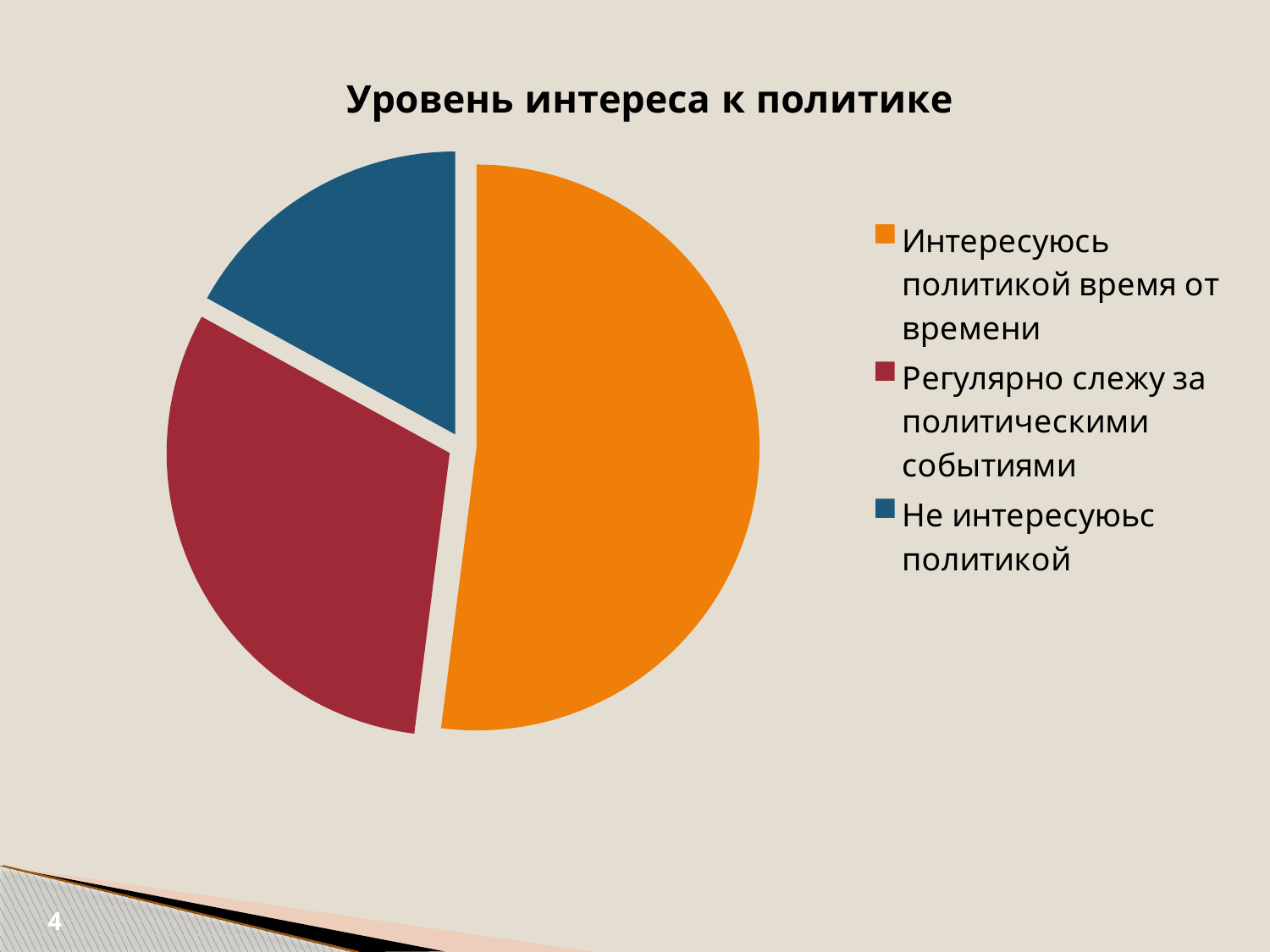
Which slice is larger: "Интересуюсь политикой время от времени" or "Регулярно слежу за политическими событиями"? Интересуюсь политикой время от времени What kind of chart is shown on the slide? Pie chart Which category has the smallest slice of the pie? Не интересуюьс политикой What colour is the slice for "Не интересуюьс политикой"? Blue What is the title of the chart? Уровень интереса к политике How many slices does the pie chart have? 3 How many entries does the legend list? 3 Which slice is larger: "Регулярно слежу за политическими событиями" or "Не интересуюьс политикой"? Регулярно слежу за политическими событиями Which category has the largest slice of the pie? Интересуюсь политикой время от времени